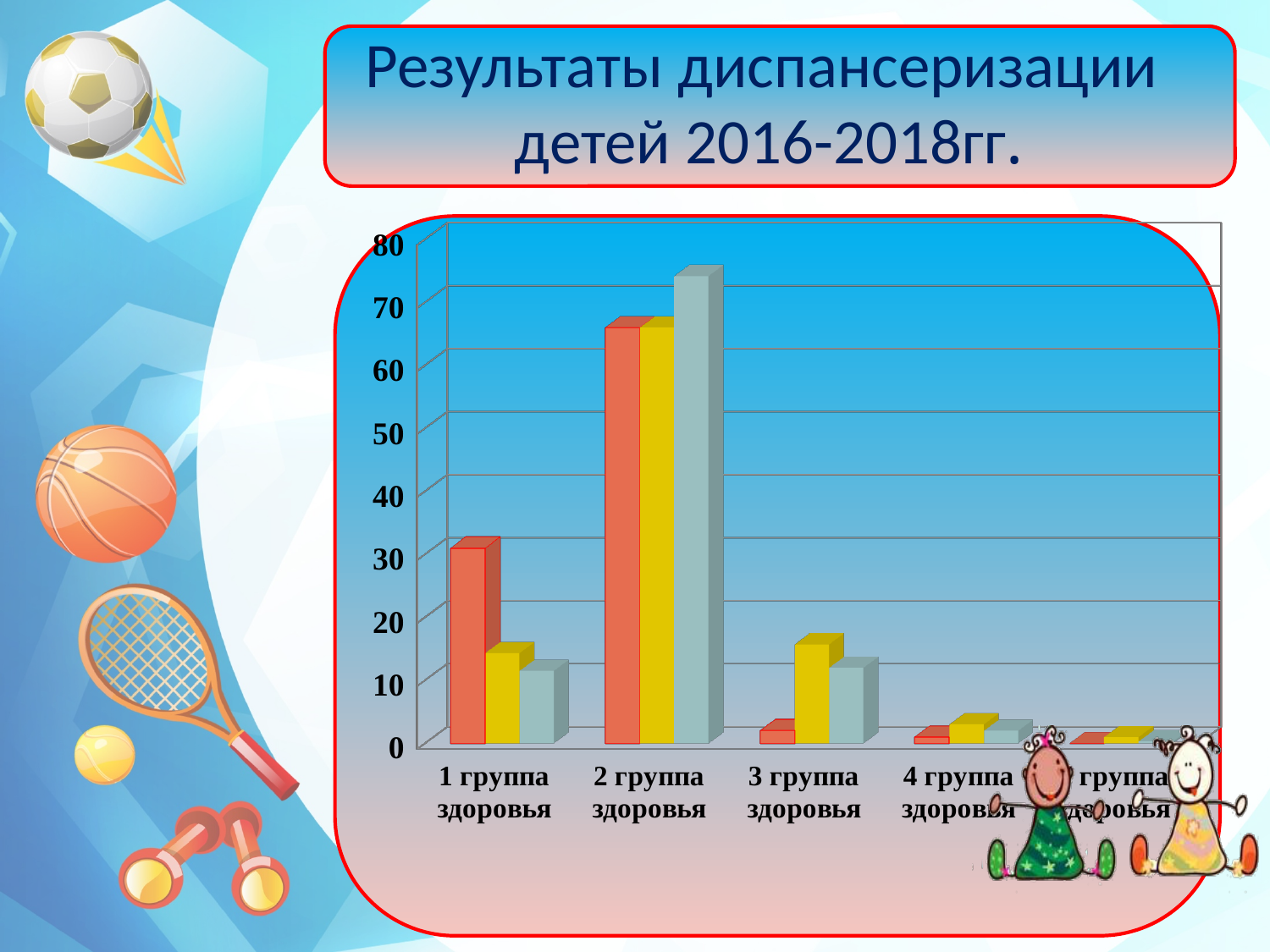
What kind of chart is shown on the slide? bar chart For 1 группа здоровья, which is larger: the red bar or the yellow bar? the red bar Is the value of the red bar for 3 группа здоровья greater or less than 10? less Is the value of the light blue bar for 2 группа здоровья greater or less than 70? greater What is the title of the slide containing the chart? Результаты диспансеризации детей 2016-2018гг. Is the value of the red bar for 1 группа здоровья greater or less than 20? greater Which health-group category has the tallest bars? 2 группа здоровья How many bars are plotted for each health-group category? 3 For 2 группа здоровья, which is larger: the red bar or the light blue bar? the light blue bar How many health-group categories are shown on the x axis? 5